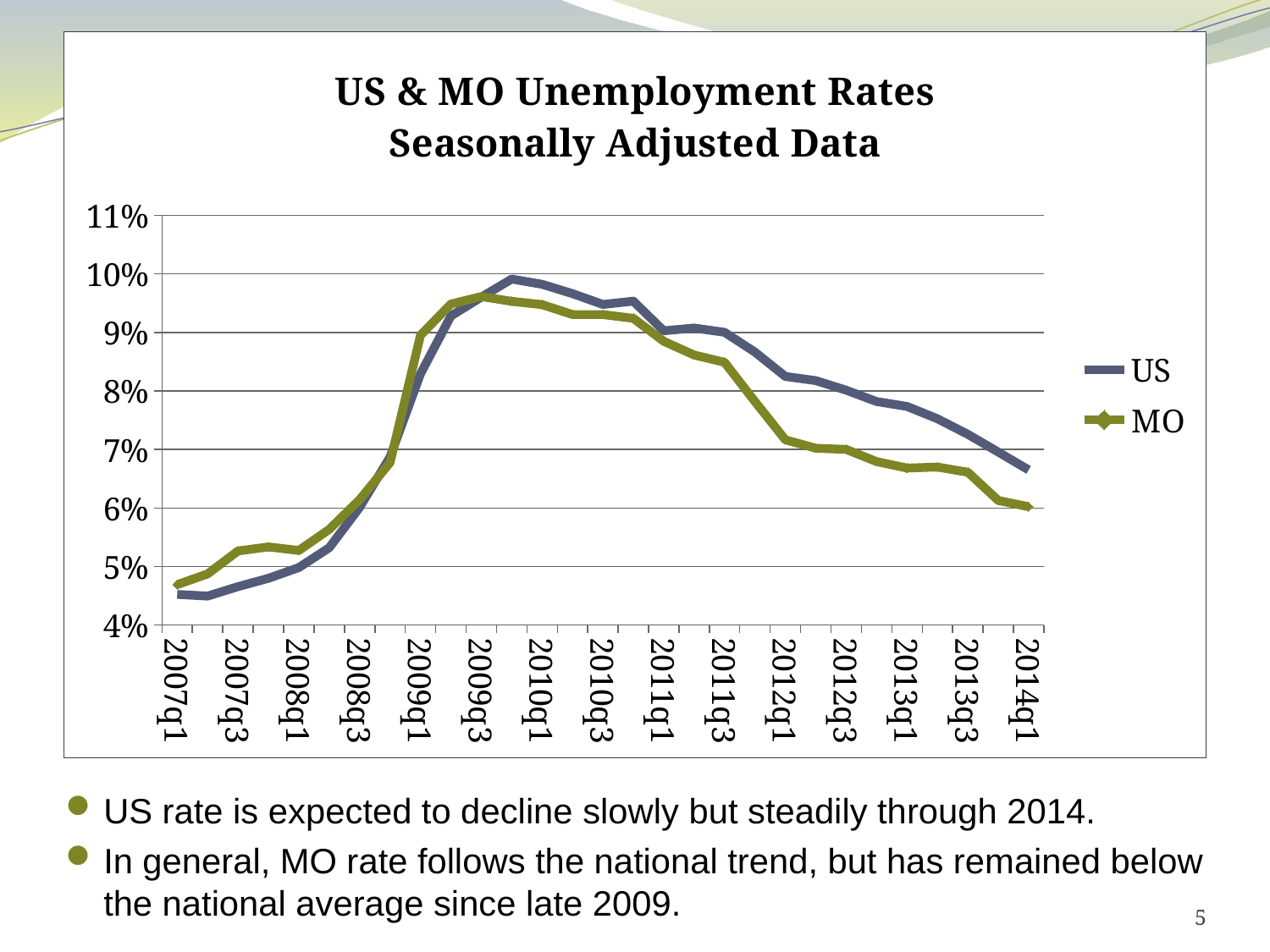
What are the two series named in the legend? US and MO How many series does the legend list? 2 What is the title of the chart? US & MO Unemployment Rates Seasonally Adjusted Data Is the MO value at 2011q3 greater or less than 8%? greater Is the US value at 2014q1 greater or less than 6%? greater At 2007q3, which series has the higher value, US or MO? MO Is the US value at 2010q1 greater or less than 9%? greater At 2014q1, which series has the higher value, US or MO? US What kind of chart is shown on the slide? line chart Which series reaches the higher peak value, US or MO? US